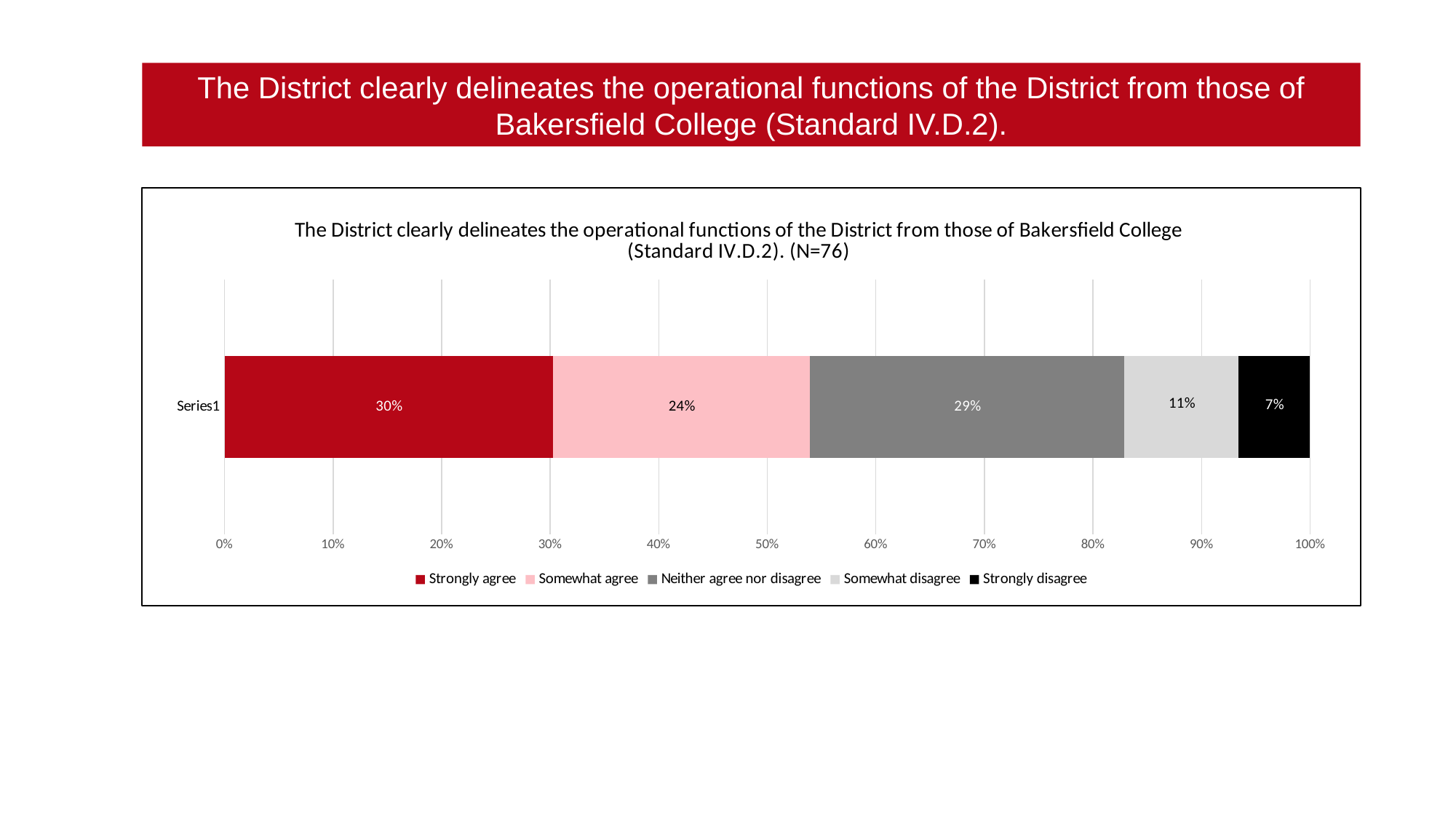
How many series does the legend list? 5 What percentage of respondents selected "Somewhat disagree"? 11% What percentage of respondents selected "Neither agree nor disagree"? 29% What kind of chart is shown on the slide? Stacked bar chart What percentage of respondents selected "Somewhat agree"? 24% What is the difference in percentage points between "Strongly agree" and "Strongly disagree"? 23 What percentage of respondents selected "Strongly agree"? 30% Which is larger, the percentage for "Somewhat agree" or for "Somewhat disagree"? Somewhat agree What is the sample size (N) stated in the chart title? 76 Which response option has the highest percentage? Strongly agree What percentage of respondents selected "Strongly disagree"? 7% Which response option has the lowest percentage? Strongly disagree